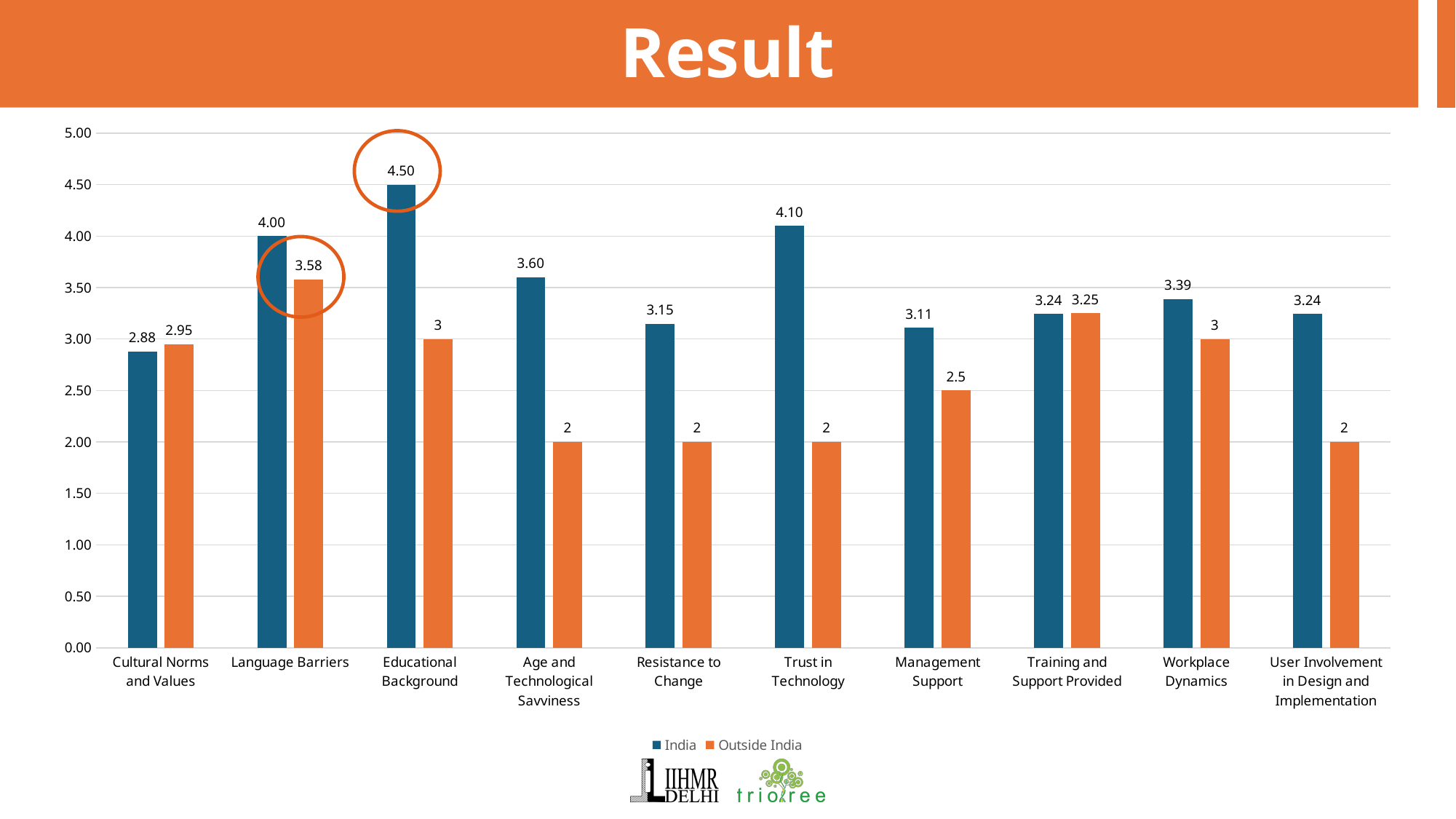
What kind of chart is shown on the slide? Bar chart How many series does the legend list? 2 Which category has the lowest value for India? Cultural Norms and Values What is the value for India for Workplace Dynamics? 3.39 What is the value for India for Educational Background? 4.50 Which category has the highest value for India? Educational Background Which category has the highest value for Outside India? Language Barriers What is the difference between the India and Outside India values for Language Barriers? 0.42 How many categories are shown on the x axis? 10 What is the value for Outside India for Management Support? 2.5 What is the difference between the India and Outside India values for Trust in Technology? 2.10 For Cultural Norms and Values, which is larger: India or Outside India? Outside India